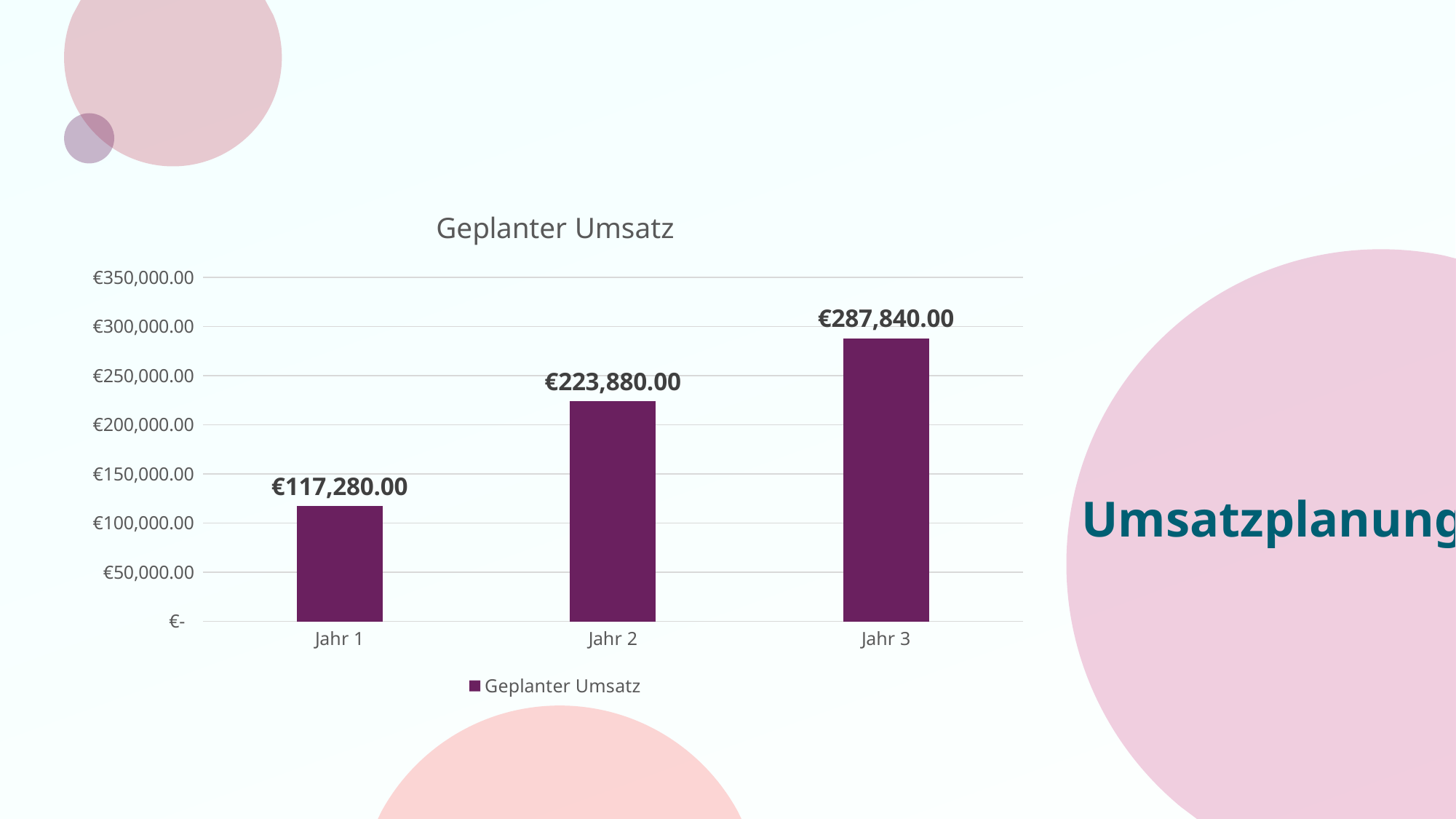
What is the planned revenue for Jahr 3? €287,840.00 What is the difference in planned revenue between Jahr 2 and Jahr 1? €106,600.00 How many years are shown on the x axis of the chart? 3 What is the planned revenue (Geplanter Umsatz) for Jahr 1? €117,280.00 What is the planned revenue for Jahr 2? €223,880.00 Which year has the lowest planned revenue? Jahr 1 Is the planned revenue for Jahr 3 greater or less than €250,000.00? greater What type of chart is shown on the slide? Bar chart What is the difference in planned revenue between Jahr 3 and Jahr 2? €63,960.00 Which year has the highest planned revenue? Jahr 3 Which is larger, the planned revenue for Jahr 1 or for Jahr 2? Jahr 2 Do the planned revenue values rise or fall from Jahr 1 to Jahr 3? Rise